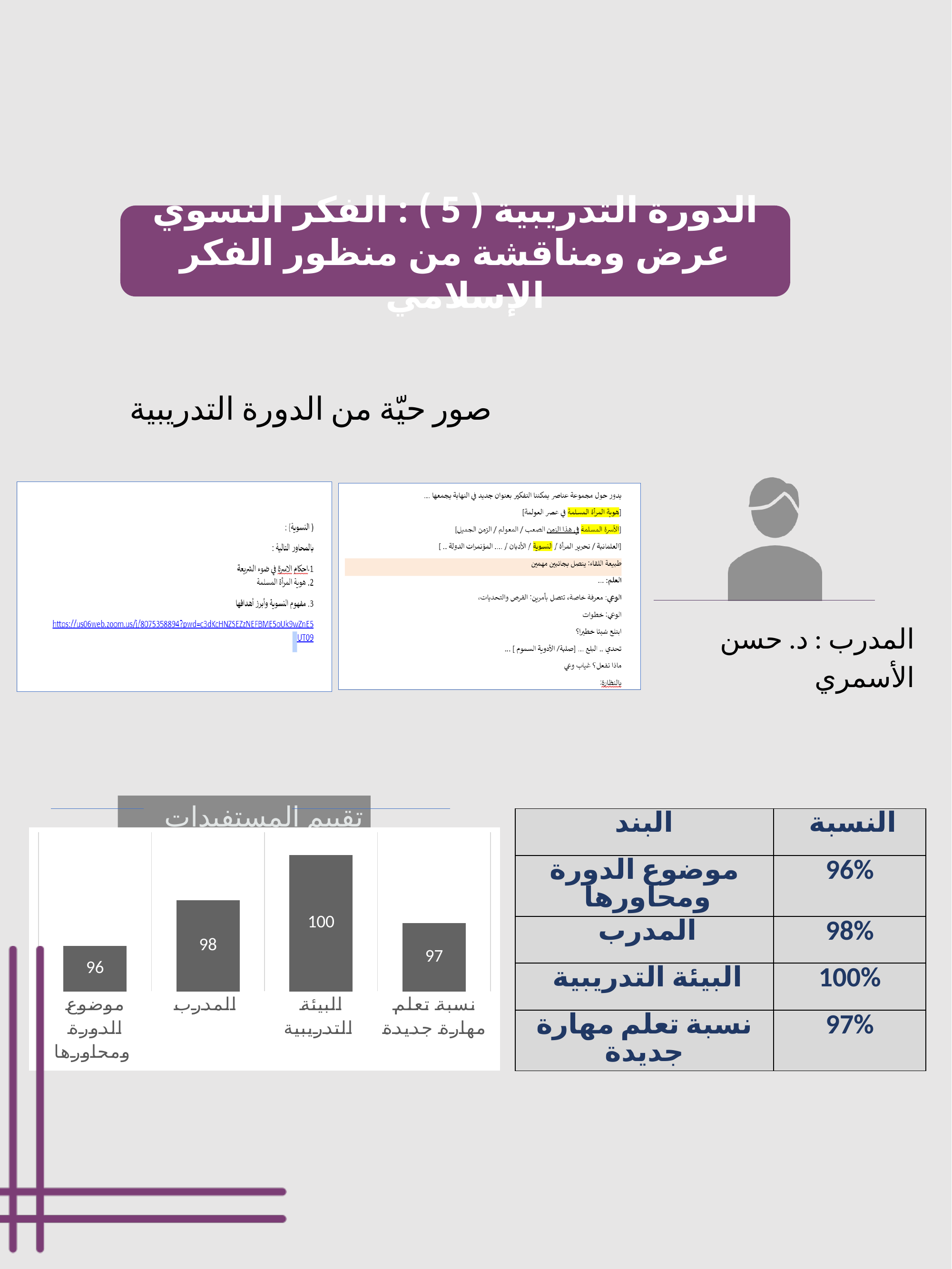
What is the title of the bar chart? تقييم المستفيدات What is the value for نسبة تعلم مهارة جديدة in the bar chart? 97 What is the difference between the values for المدرب and نسبة تعلم مهارة جديدة? 1 What is the value for البيئة التدريبية in the bar chart? 100 Which is larger in the bar chart, the value for المدرب or the value for نسبة تعلم مهارة جديدة? المدرب What type of chart is shown on the slide? bar chart What is the value for موضوع الدورة ومحاورها in the bar chart? 96 How many categories does the bar chart show? 4 Which category has the highest value in the bar chart? البيئة التدريبية What is the value for المدرب in the bar chart? 98 Which category has the lowest value in the bar chart? موضوع الدورة ومحاورها What is the difference between the values for البيئة التدريبية and موضوع الدورة ومحاورها? 4